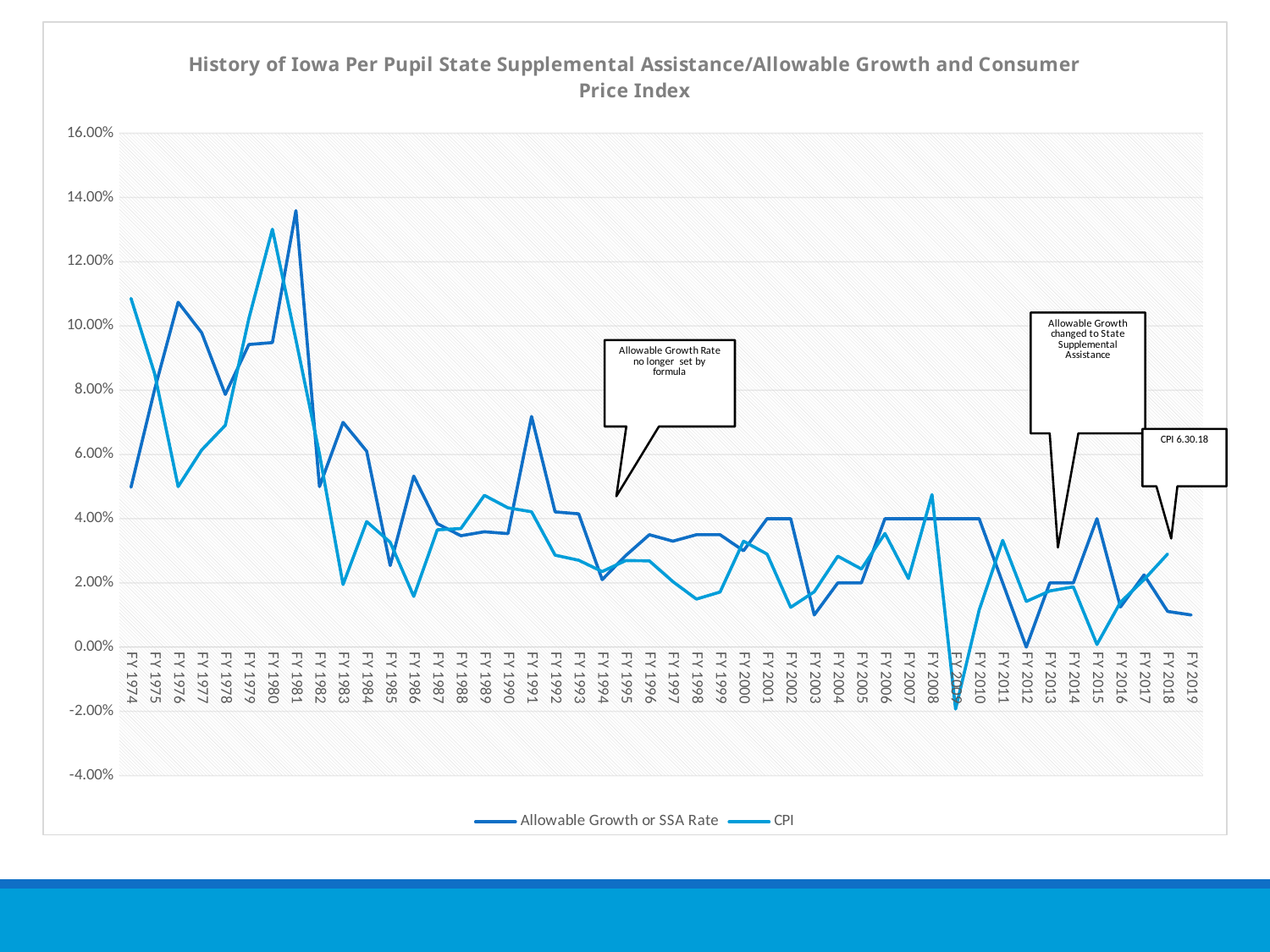
How many fiscal years are plotted along the x axis? 46 What are the two series named in the legend? Allowable Growth or SSA Rate and CPI Is the CPI value for FY 2009 greater or less than 0.00%? less What kind of chart is shown on the slide? Line chart Is the Allowable Growth or SSA Rate value for FY 1981 greater or less than 12.00%? greater In which fiscal year does the CPI series reach its lowest value? FY 2009 In which fiscal year does the Allowable Growth or SSA Rate series reach its highest value? FY 1981 In FY 1974, which series has the larger value, Allowable Growth or SSA Rate or CPI? CPI How many series does the legend list? 2 Does the Allowable Growth or SSA Rate series generally rise or fall from FY 1974 to FY 2019? Fall Is the Allowable Growth or SSA Rate value for FY 2012 greater or less than 2.00%? less In which fiscal year does the CPI series reach its highest value? FY 1980